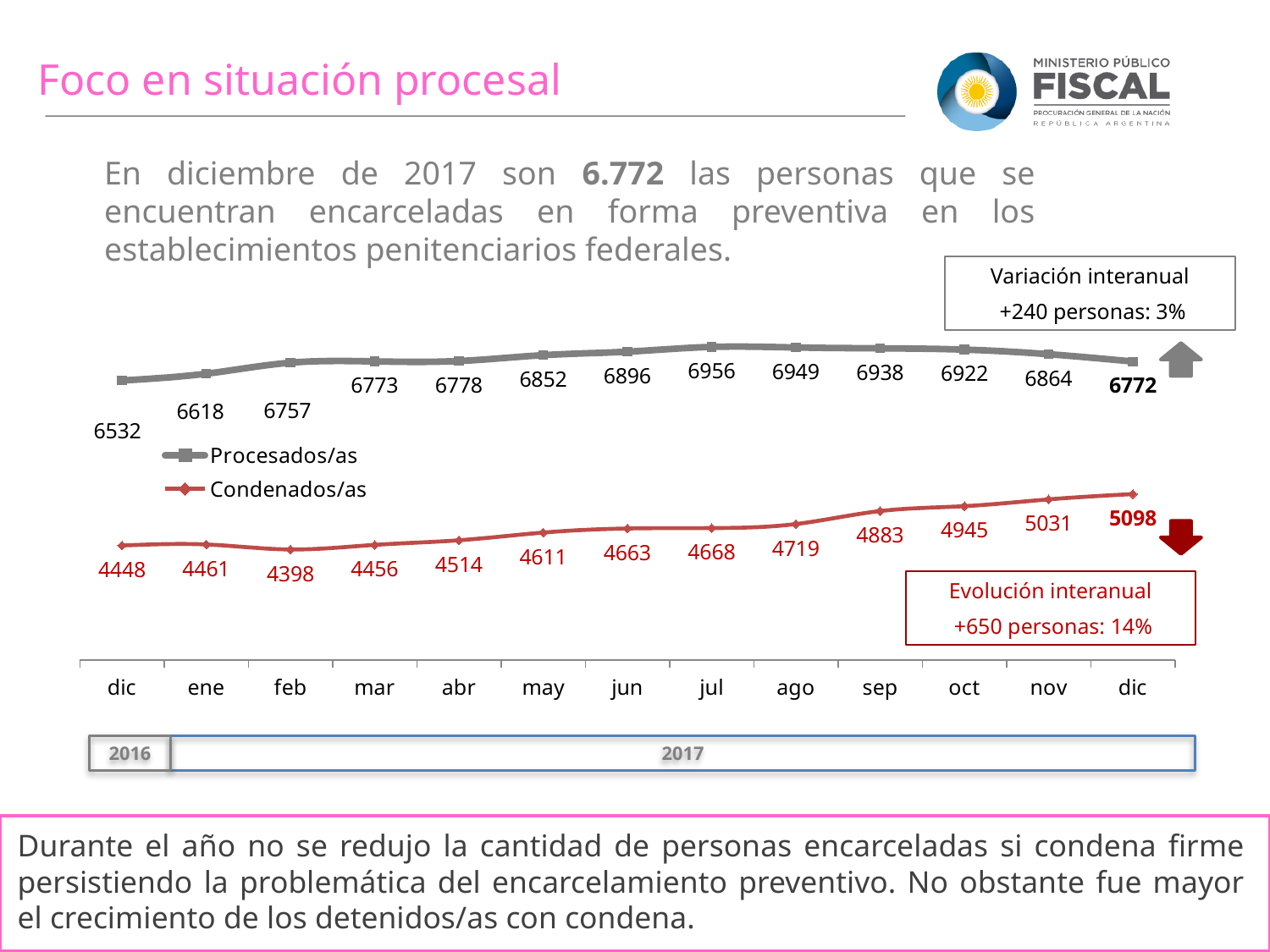
What is the difference between the Condenados/as value in dic 2017 and in dic 2016? 650 What is the value for Procesados/as in the first dic (2016)? 6532 Which is larger in sep: the Procesados/as value or the Condenados/as value? Procesados/as Does the Condenados/as series generally rise or fall from dic 2016 to dic 2017? rise What is the difference between the Procesados/as value in dic 2017 and in dic 2016? 240 How many months (data points) are plotted for each series? 13 In which month does the Condenados/as series have its lowest value? feb What is the value for Condenados/as in abr? 4514 How many series does the legend list? 2 In which month does the Procesados/as series reach its highest value? jul What kind of chart is shown on the slide? line chart What is the value for Procesados/as in jul? 6956